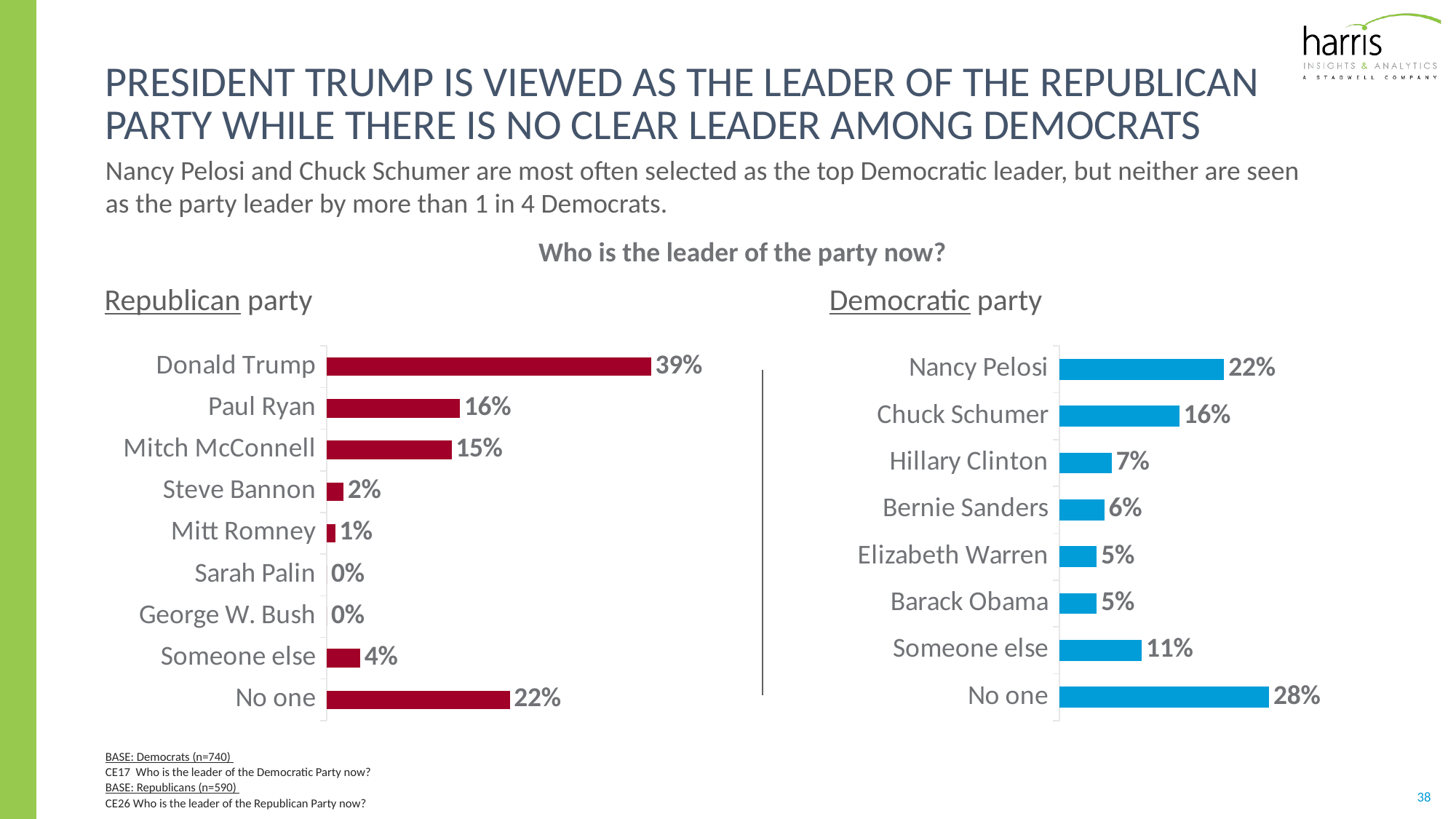
In the Democratic party chart, what percentage is shown for Nancy Pelosi? 22% In the Democratic party chart, what percentage is shown for Bernie Sanders? 6% How many categories are shown in the Democratic party chart? 8 Which is larger: the value for Mitch McConnell in the Republican party chart or the value for Chuck Schumer in the Democratic party chart? Chuck Schumer In the Republican party chart, which category has the highest value? Donald Trump How many categories are shown in the Republican party chart? 9 In the Democratic party chart, which named person has the lowest value? Elizabeth Warren and Barack Obama (5%) In the Democratic party chart, what is the difference between No one and Nancy Pelosi? 6 percentage points What type of chart is used for the Democratic party data? Bar chart In the Republican party chart, what is the difference between Donald Trump and Paul Ryan? 23 percentage points In the Democratic party chart, which category has the highest value? No one In the Republican party chart, what percentage is shown for Donald Trump? 39%